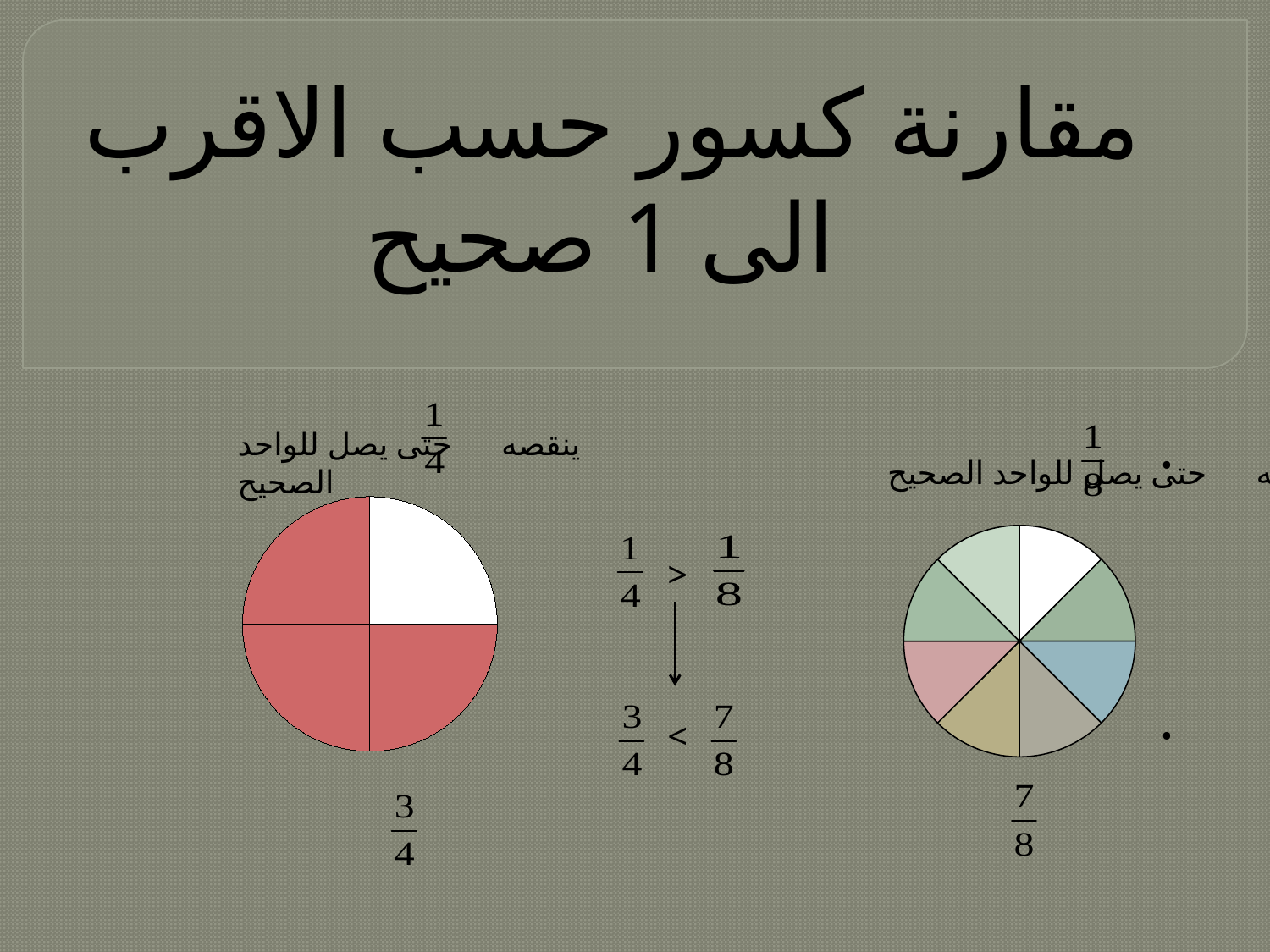
Which is larger according to the comparison printed between the two pie charts, 3/4 or 7/8? 7/8 In the pie chart on the right, what share of the pie do the coloured slices represent? 7/8 In the pie chart on the right, what share of the pie is the white slice? 1/8 What fraction is printed below the pie chart on the left? 3/4 In the pie chart on the left, what share of the pie do the red slices represent? 3/4 What kind of chart is the chart on the right side of the slide? pie chart What kind of chart is the chart on the left side of the slide? pie chart What fraction is printed below the pie chart on the right? 7/8 How many slices is the pie chart on the left divided into? 4 How many slices in the pie chart on the left are shaded red? 3 How many slices is the pie chart on the right divided into? 8